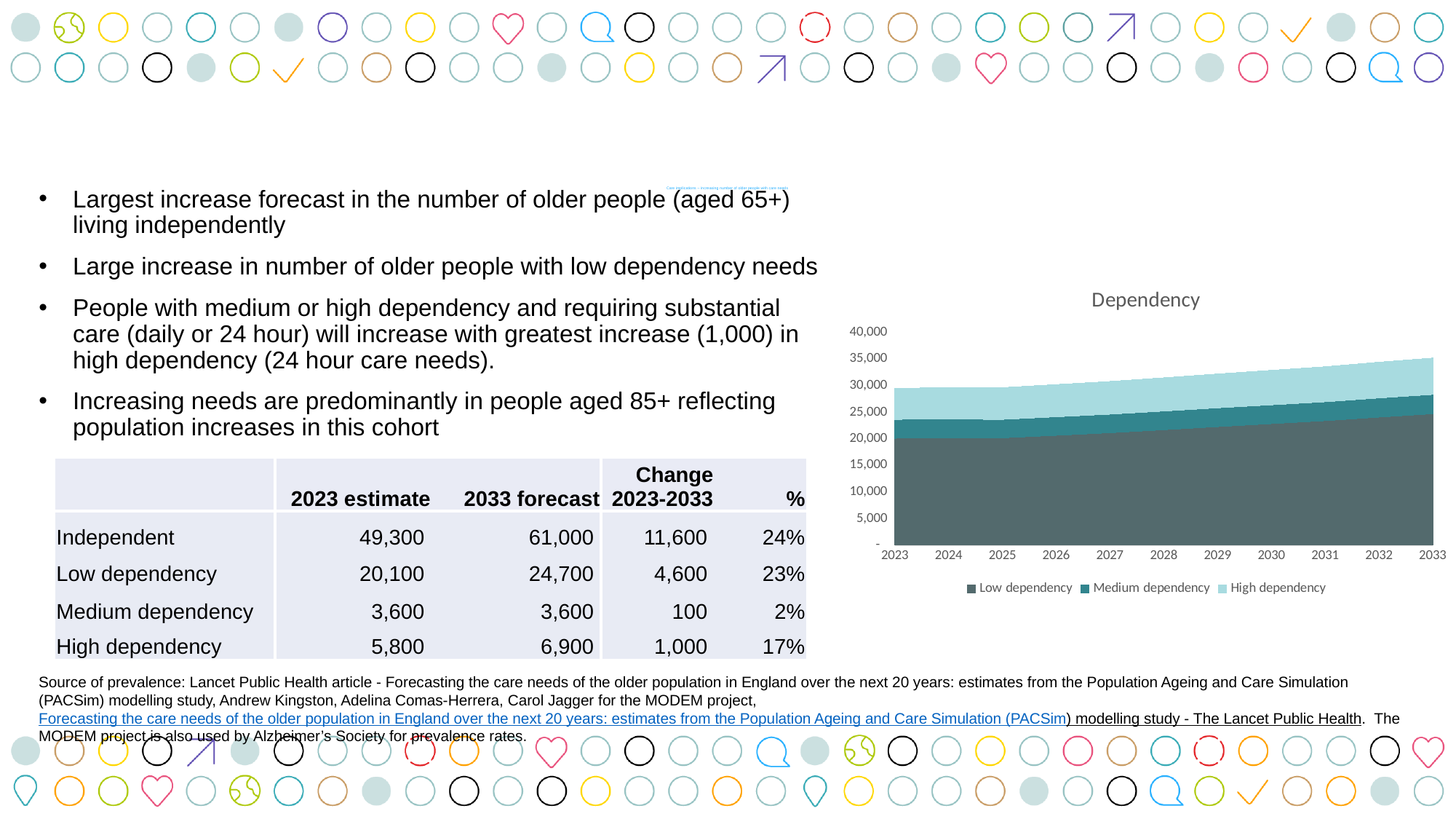
What kind of chart is the Dependency chart? area chart In the Dependency chart, is the stacked total for 2023 greater or less than 35,000? less In the Dependency chart, is the value for Low dependency in 2023 greater or less than 25,000? less In the Dependency chart, which series has the largest values across the years? Low dependency In the Dependency chart, is the stacked total for 2033 greater or less than 30,000? greater How many years are shown on the x axis of the Dependency chart? 11 Does the total across all dependency levels rise or fall from 2023 to 2033 in the Dependency chart? rise How many series does the legend of the Dependency chart list? 3 What is the last year shown on the x axis of the Dependency chart? 2033 What is the first year shown on the x axis of the Dependency chart? 2023 In the Dependency chart, which is larger in 2033: Low dependency or High dependency? Low dependency